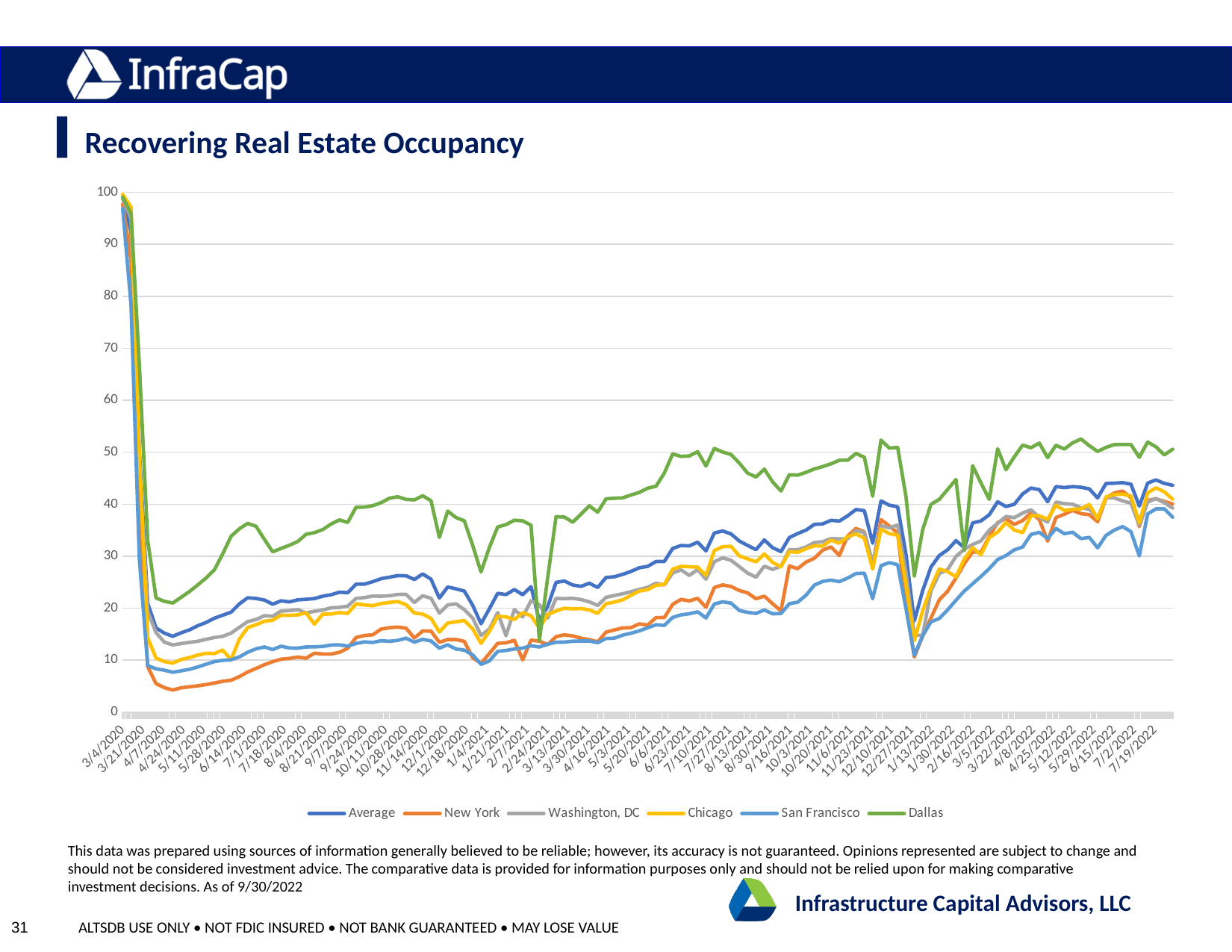
How many series does the legend list? 6 Is the value for Average at 7/19/2022 greater or less than 40? greater At 6/6/2021, which is larger: the value for Dallas or the value for New York? Dallas Is the value for New York at 4/24/2020 greater or less than 10? less Which series has the lowest value at 4/24/2020? New York Which series has the highest value at 7/19/2022? Dallas Do the values for Average rise or fall between 3/4/2020 and 4/7/2020? Fall Which colour is used for the Dallas line? Green Is the value for Dallas at 6/6/2021 greater or less than 40? greater Which series has the lowest value at 1/13/2022? San Francisco What is the title of the chart on the slide? Recovering Real Estate Occupancy What kind of chart is shown on the slide? Line chart